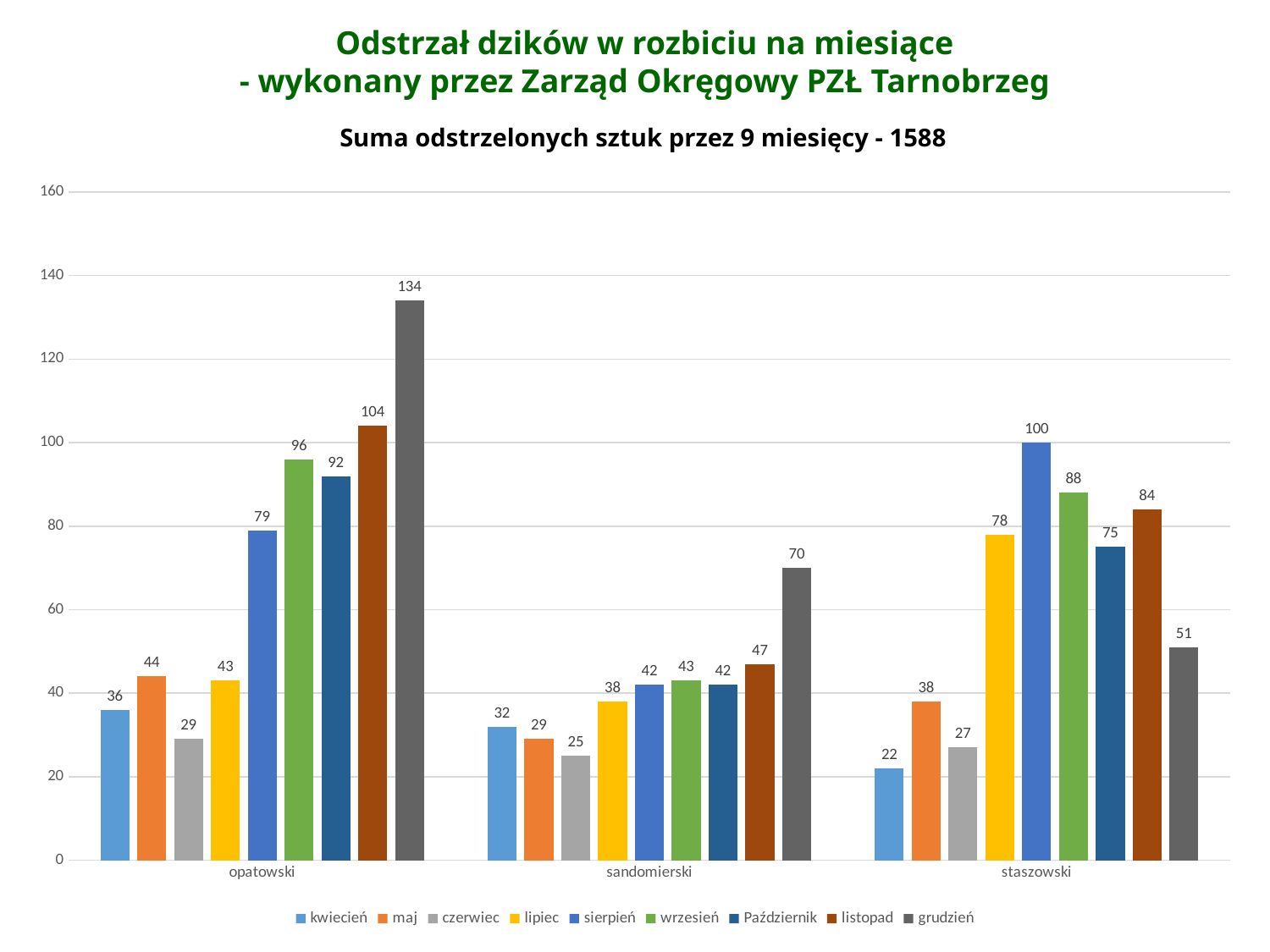
What total number of animals shot over 9 months is stated in the subtitle? 1588 Which is larger: the listopad value for opatowski or the listopad value for staszowski? opatowski How many category groups are shown on the x axis? 3 What is the value for sierpień in the staszowski group? 100 What is the value for grudzień in the opatowski group? 134 Which month has the highest value in the staszowski group? sierpień How many series does the legend list? 9 Which month has the lowest value in the opatowski group? czerwiec What is the value for czerwiec in the sandomierski group? 25 What is the difference between the grudzień values for opatowski and sandomierski? 64 What kind of chart is shown on the slide? bar chart Is the value for wrzesień in the staszowski group greater or less than 80? greater